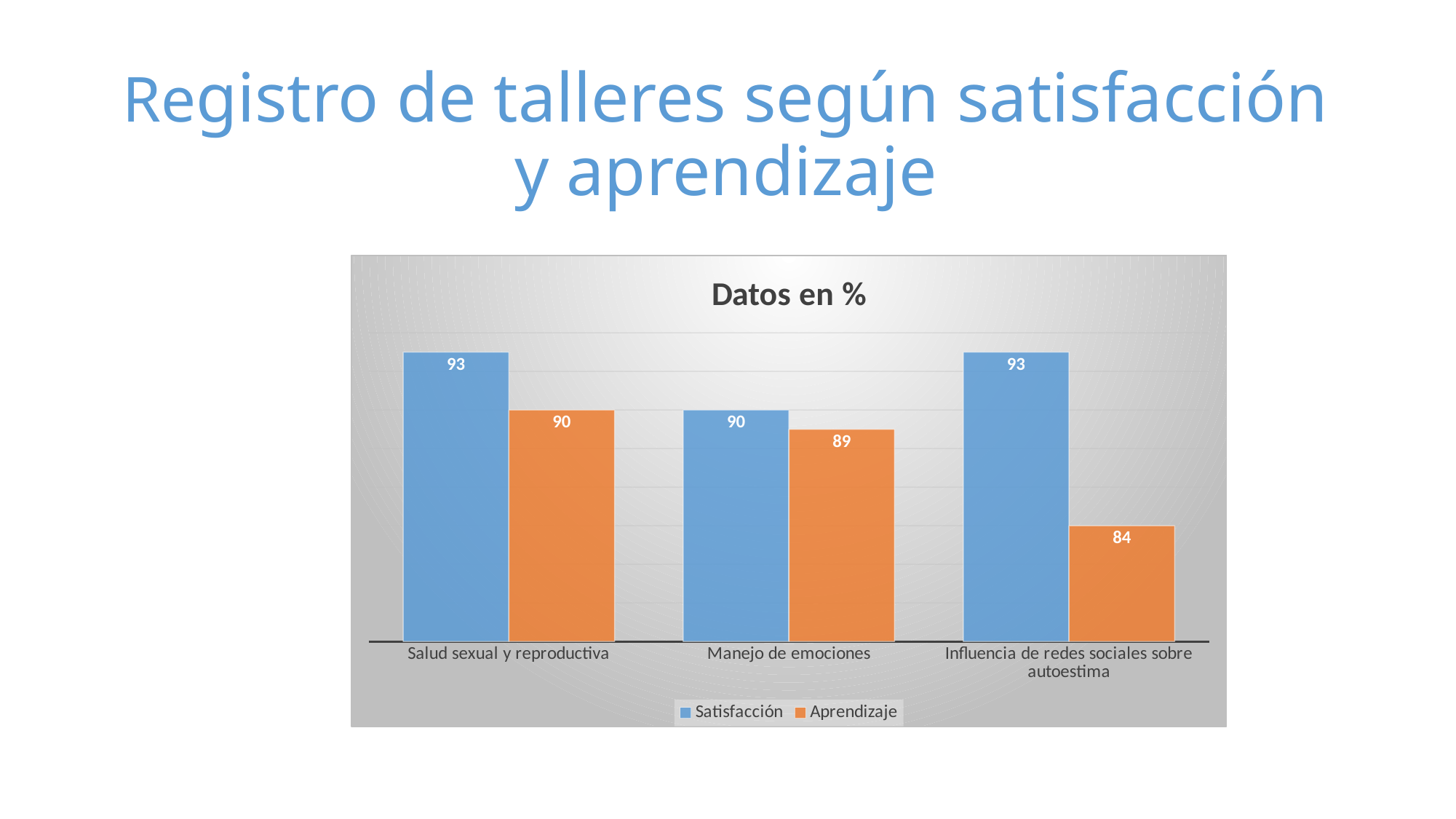
What is the Satisfacción value for Manejo de emociones? 90 What is the difference between the Aprendizaje values for Salud sexual y reproductiva and Influencia de redes sociales sobre autoestima? 6 How many series does the legend list? 2 Which category has the highest Aprendizaje value? Salud sexual y reproductiva What is the Satisfacción value for Salud sexual y reproductiva? 93 How many categories are shown on the x axis? 3 What is the Aprendizaje value for Manejo de emociones? 89 Which is larger: the Satisfacción value for Manejo de emociones or the Aprendizaje value for Salud sexual y reproductiva? They are equal (90) What kind of chart is shown on the slide? Bar chart What is the Aprendizaje value for Influencia de redes sociales sobre autoestima? 84 What is the difference between the Satisfacción and Aprendizaje values for Influencia de redes sociales sobre autoestima? 9 Which category has the lowest Aprendizaje value? Influencia de redes sociales sobre autoestima